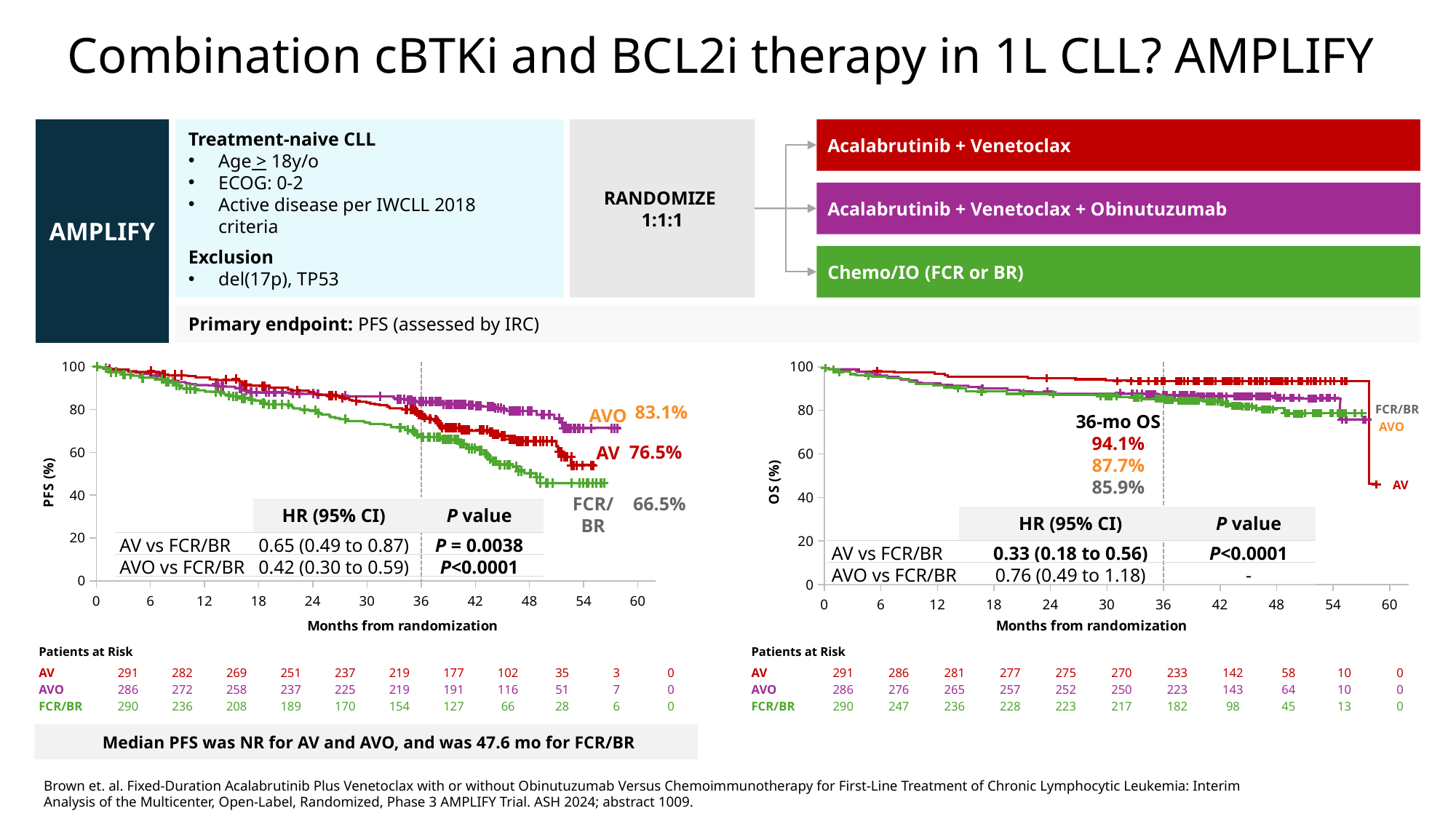
On the left PFS chart, which arm has the lowest labeled PFS value? FCR/BR On the left PFS chart, do the curves rise or fall as months from randomization increase? fall On the left PFS chart, what PFS value is labeled for the AVO arm? 83.1% On the right OS chart, what is the 36-month OS for the AV arm? 94.1% On the right OS chart, which arm has the highest 36-month OS? AV On the right OS chart, what is the HR (95% CI) for AV vs FCR/BR? 0.33 (0.18 to 0.56) On the right OS chart, what is the difference between the 36-month OS for AV and FCR/BR? 8.2 percentage points On the left PFS chart, what is the P value shown for AV vs FCR/BR? P = 0.0038 On the left PFS chart, what is the difference between the labeled PFS values for AVO and FCR/BR? 16.6 percentage points On the left PFS chart, how many patients were at risk in the AV arm at 0 months? 291 How many treatment arms are plotted on the left PFS chart? 3 On the left PFS chart, what PFS value is labeled for the AV arm? 76.5%